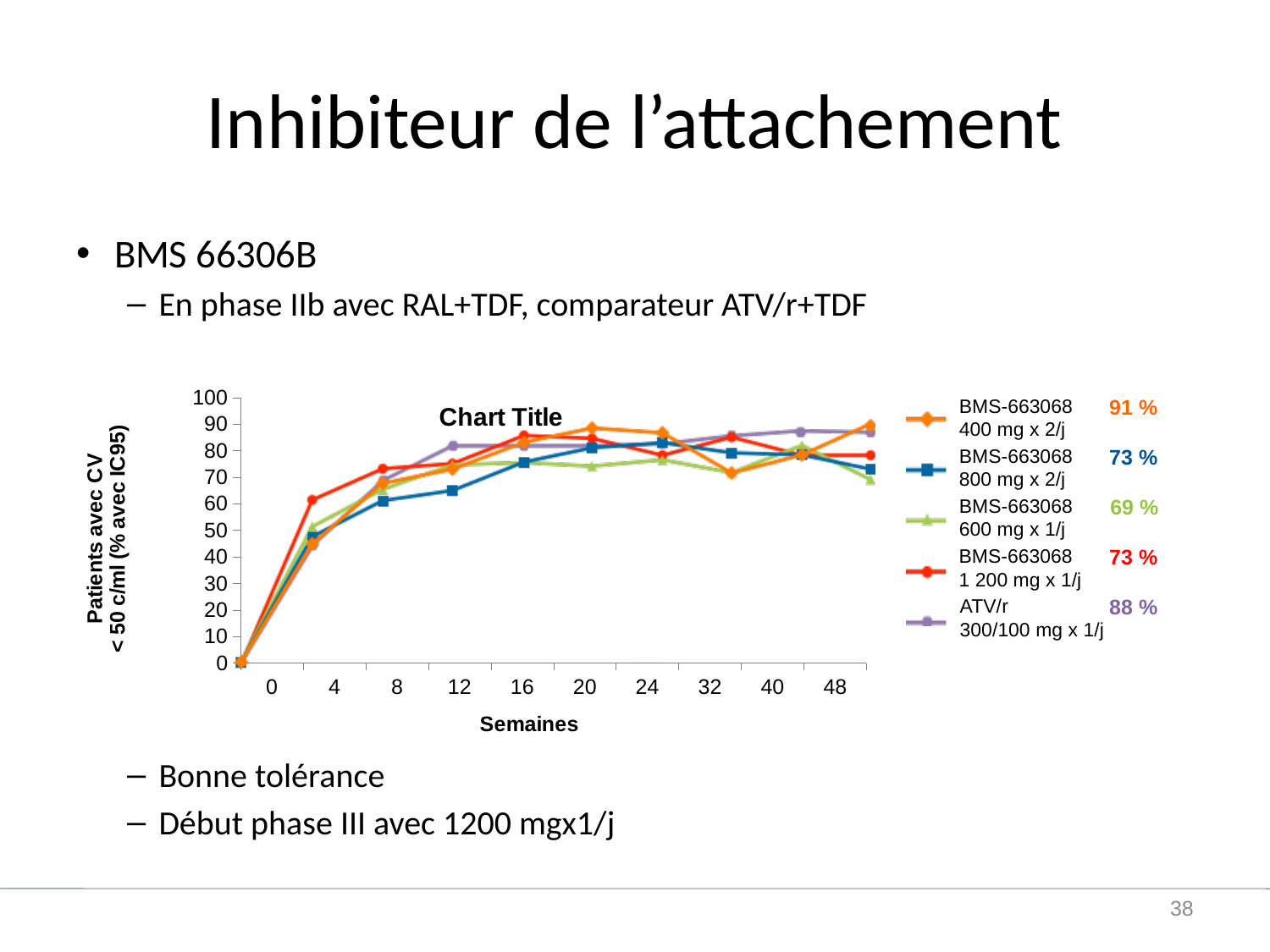
Which series has the lowest final percentage printed in the legend? BMS-663068 600 mg x 1/j How many week values are marked on the x axis of the chart? 10 What final percentage is printed next to the legend entry BMS-663068 400 mg x 2/j? 91 % Is the value for BMS-663068 800 mg x 2/j at week 8 greater or less than 70? less Which series has the highest final percentage printed in the legend? BMS-663068 400 mg x 2/j What kind of chart is shown on the slide? line chart What final percentage is printed next to the legend entry BMS-663068 600 mg x 1/j? 69 % Which has the larger final percentage printed in the legend: BMS-663068 800 mg x 2/j or ATV/r 300/100 mg x 1/j? ATV/r 300/100 mg x 1/j What is the difference between the final percentages printed for BMS-663068 400 mg x 2/j and ATV/r 300/100 mg x 1/j? 3 % What is the label of the x axis of the chart? Semaines What final percentage is printed next to the legend entry ATV/r 300/100 mg x 1/j? 88 % How many series does the chart legend list? 5